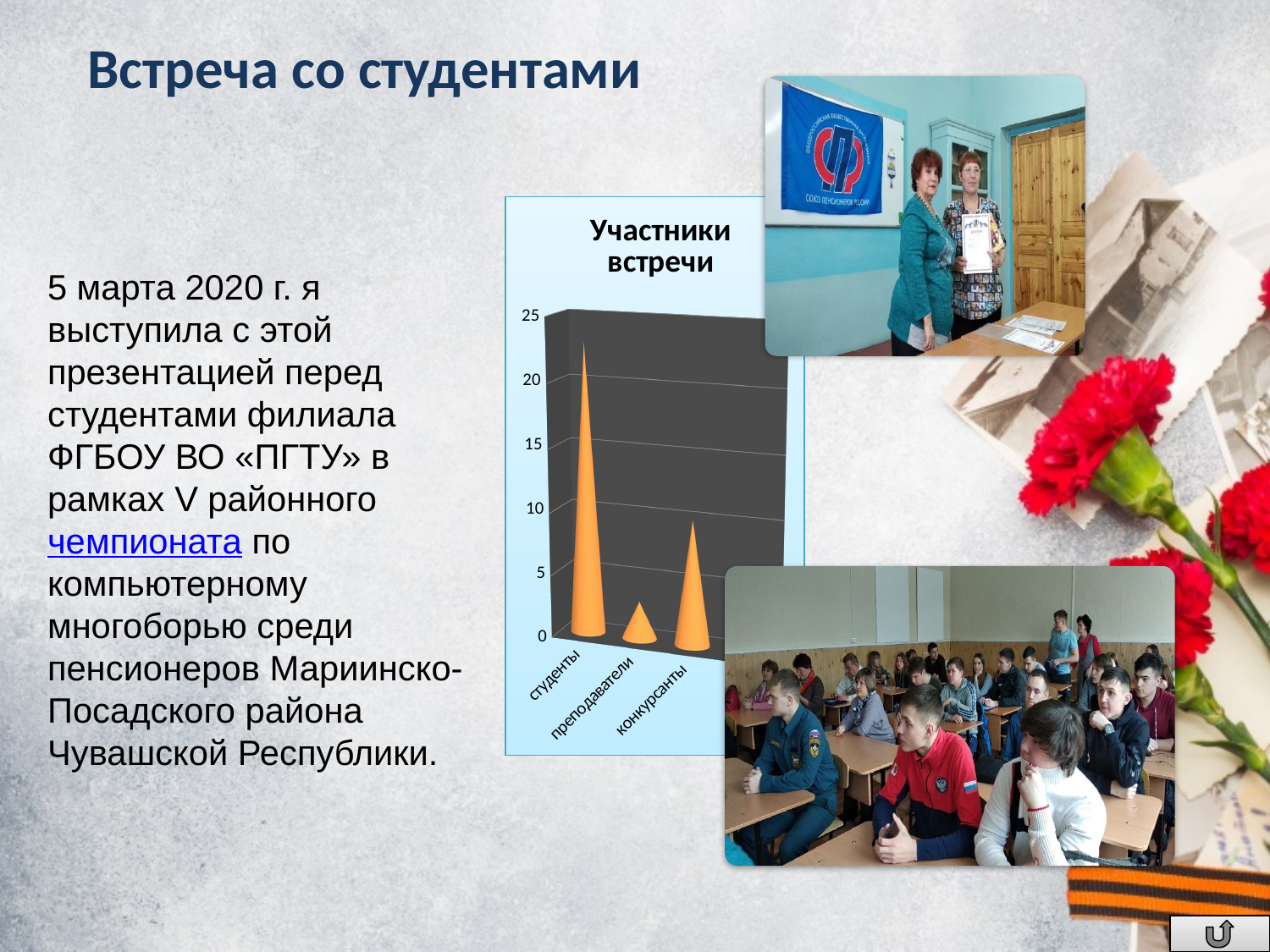
What is the highest tick value shown on the vertical axis of the chart? 25 Which is larger, the value for конкурсанты or the value for преподаватели? конкурсанты What is the title of the chart on the slide? Участники встречи Which category has the lowest value in the chart? преподаватели What kind of chart is shown on the slide? bar chart How many categories are shown on the x axis of the chart? 3 Which is larger, the value for студенты or the value for конкурсанты? студенты Is the value for преподаватели greater or less than 5? less Is the value for конкурсанты greater or less than 5? greater Is the value for студенты greater or less than 20? greater Which category has the highest value in the chart? студенты